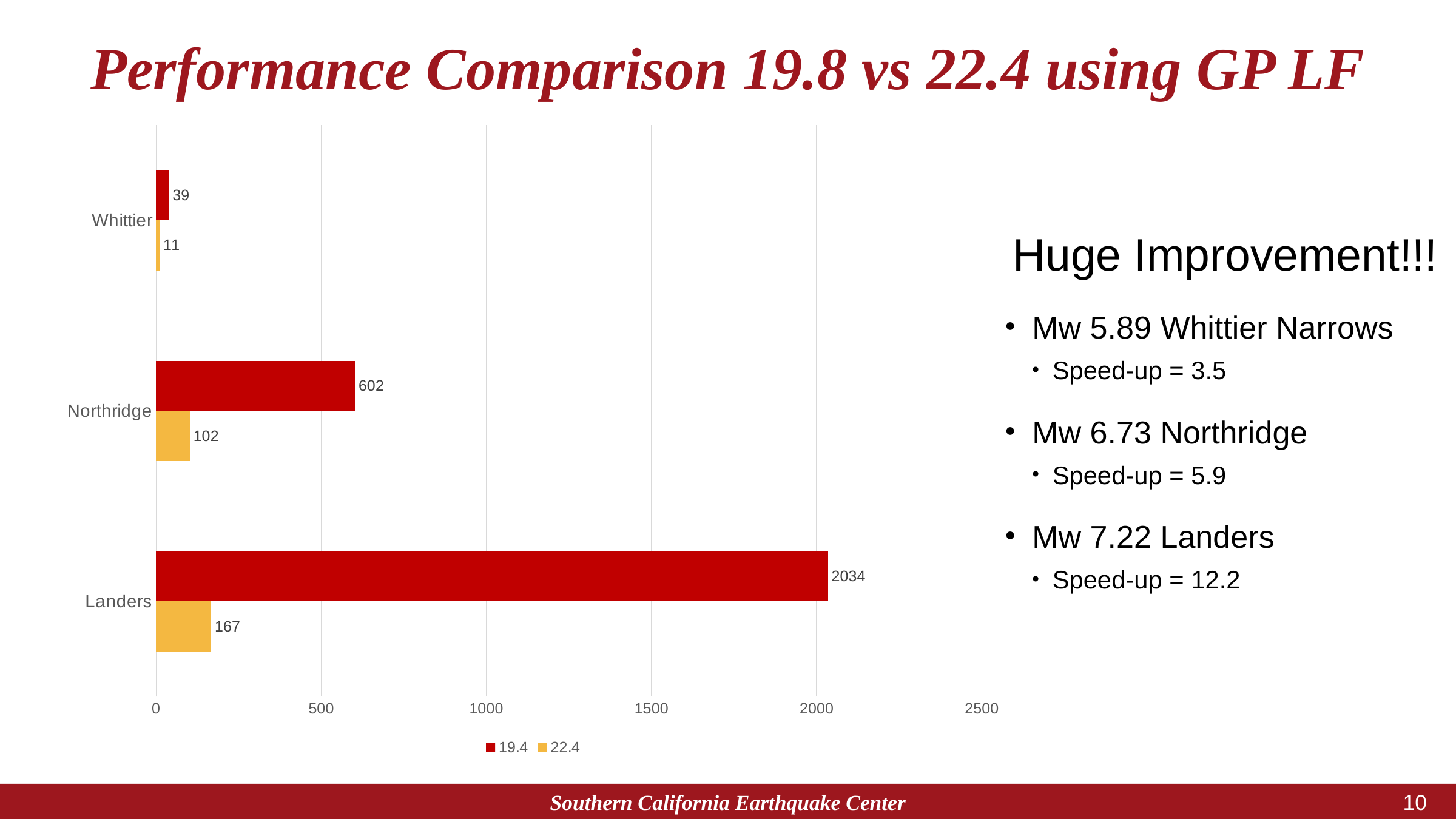
What is the difference between the 19.4 and 22.4 values for Landers? 1867 What is the value for Northridge in the 22.4 series? 102 What kind of chart is shown on the slide? bar chart Is the 19.4 value for Northridge greater or less than 500? greater What is the value for Whittier in the 19.4 series? 39 How many series does the legend list? 2 Which category has the lowest value in the 22.4 series? Whittier How many categories are shown on the chart? 3 Which is larger for Whittier: the 19.4 value or the 22.4 value? 19.4 What is the difference between the 19.4 and 22.4 values for Northridge? 500 Which category has the highest value in the 19.4 series? Landers What is the value for Landers in the 19.4 series? 2034